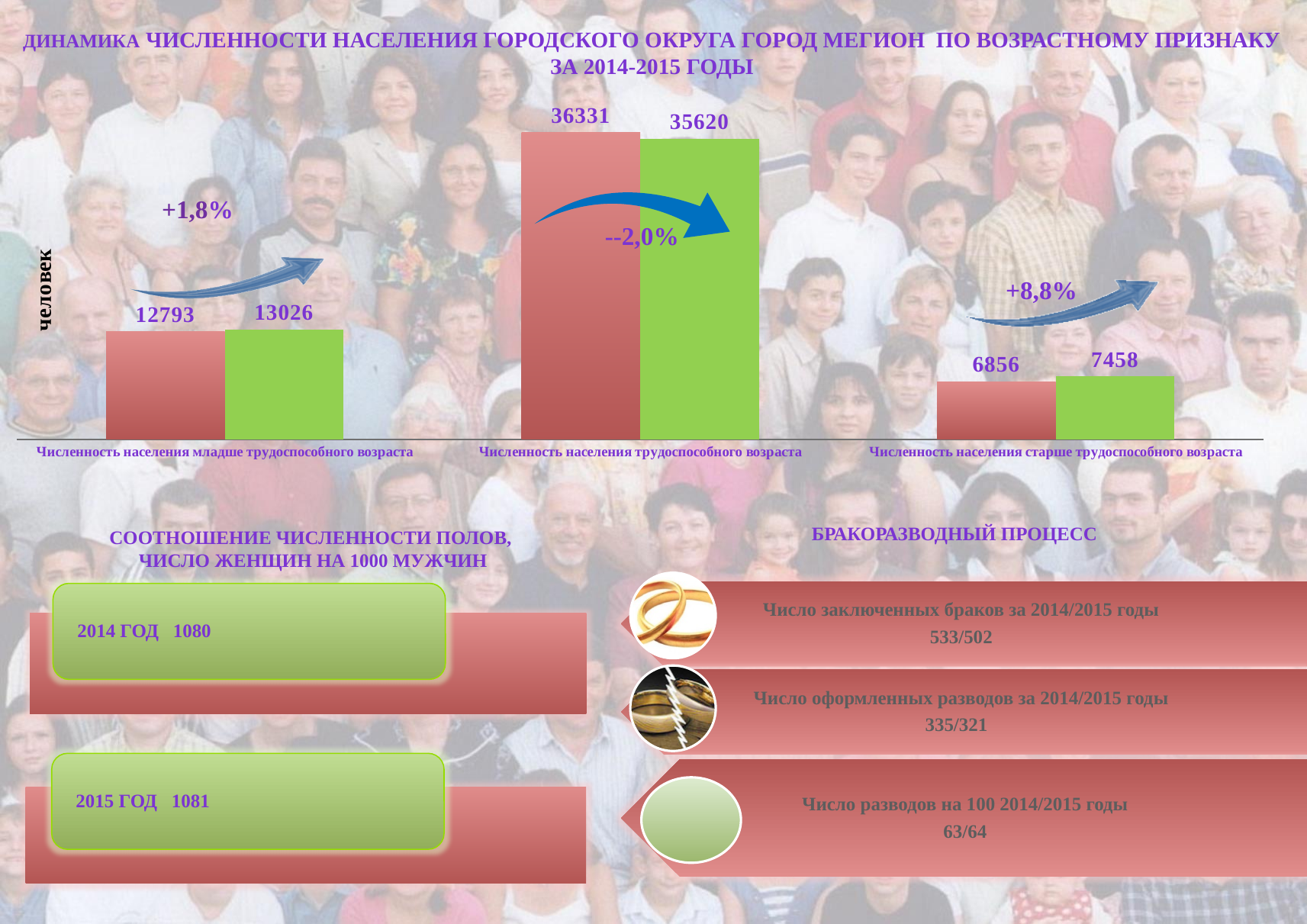
What type of chart is shown at the top of the slide? bar chart For 'Численность населения старше трудоспособного возраста', which bar is larger, the red one or the green one? the green one How many categories are shown on the x axis of the bar chart? 3 What is the value of the red bar for 'Численность населения трудоспособного возраста'? 36331 What is the value of the red bar for 'Численность населения младше трудоспособного возраста'? 12793 What is the value of the green bar for 'Численность населения старше трудоспособного возраста'? 7458 Which category has the highest bars in the chart? Численность населения трудоспособного возраста What is the value of the green bar for 'Численность населения трудоспособного возраста'? 35620 What is the difference between the green bar (13026) and the red bar (12793) for 'Численность населения младше трудоспособного возраста'? 233 Which category has the lowest bars in the chart? Численность населения старше трудоспособного возраста What is the difference between the red bar (36331) and the green bar (35620) for 'Численность населения трудоспособного возраста'? 711 What percentage change is shown above the bars for 'Численность населения старше трудоспособного возраста'? +8,8%